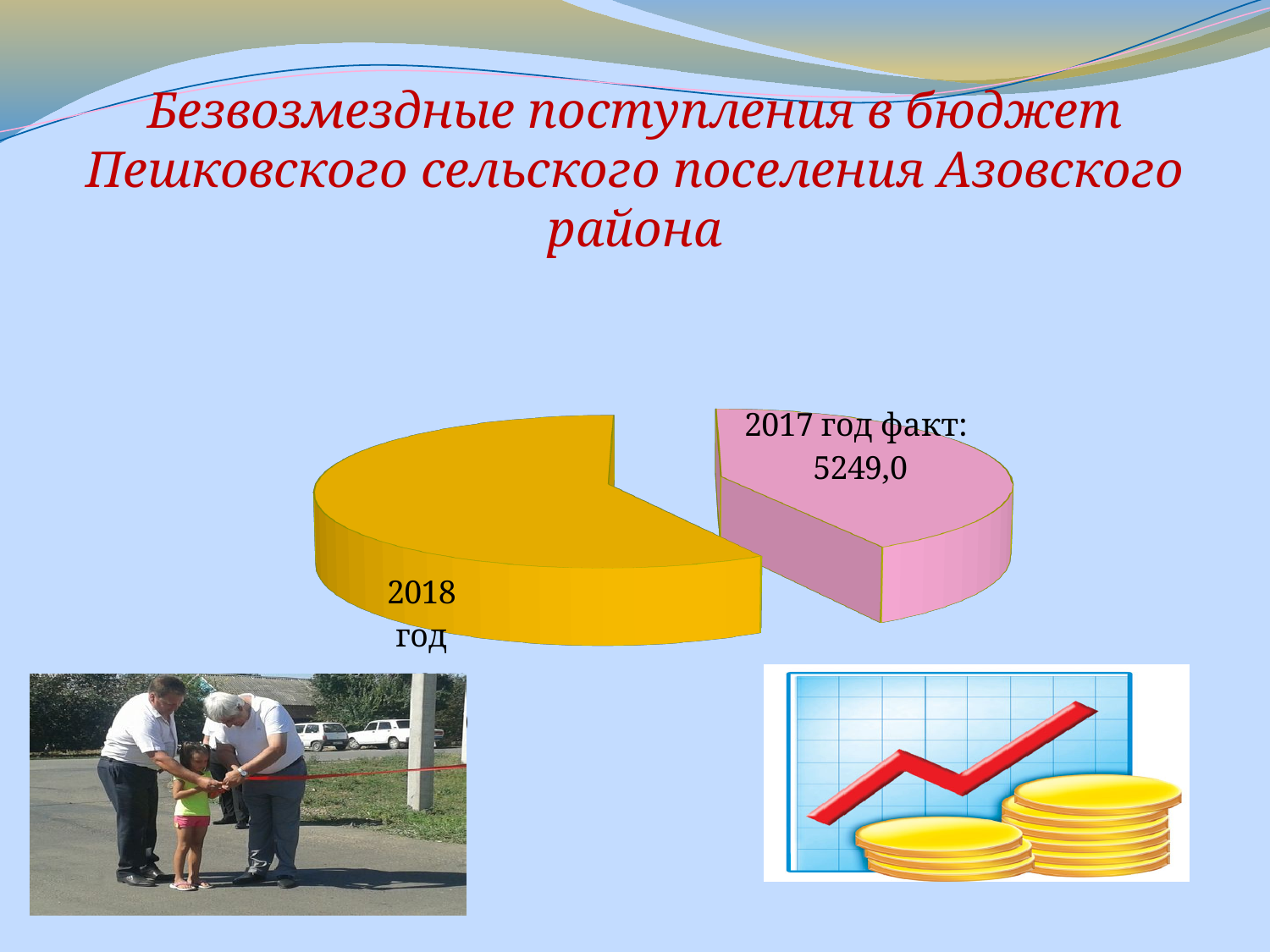
How many slices does the pie chart have? 2 What value is printed for the 2017 год факт slice? 5249,0 What colour is the 2017 год факт slice? pink What colour is the 2018 год slice? yellow Which slice of the pie chart is the smallest? 2017 год факт Which slice of the pie chart is the largest? 2018 год What kind of chart is shown on the slide? pie chart Which slice is larger, 2018 год or 2017 год факт? 2018 год